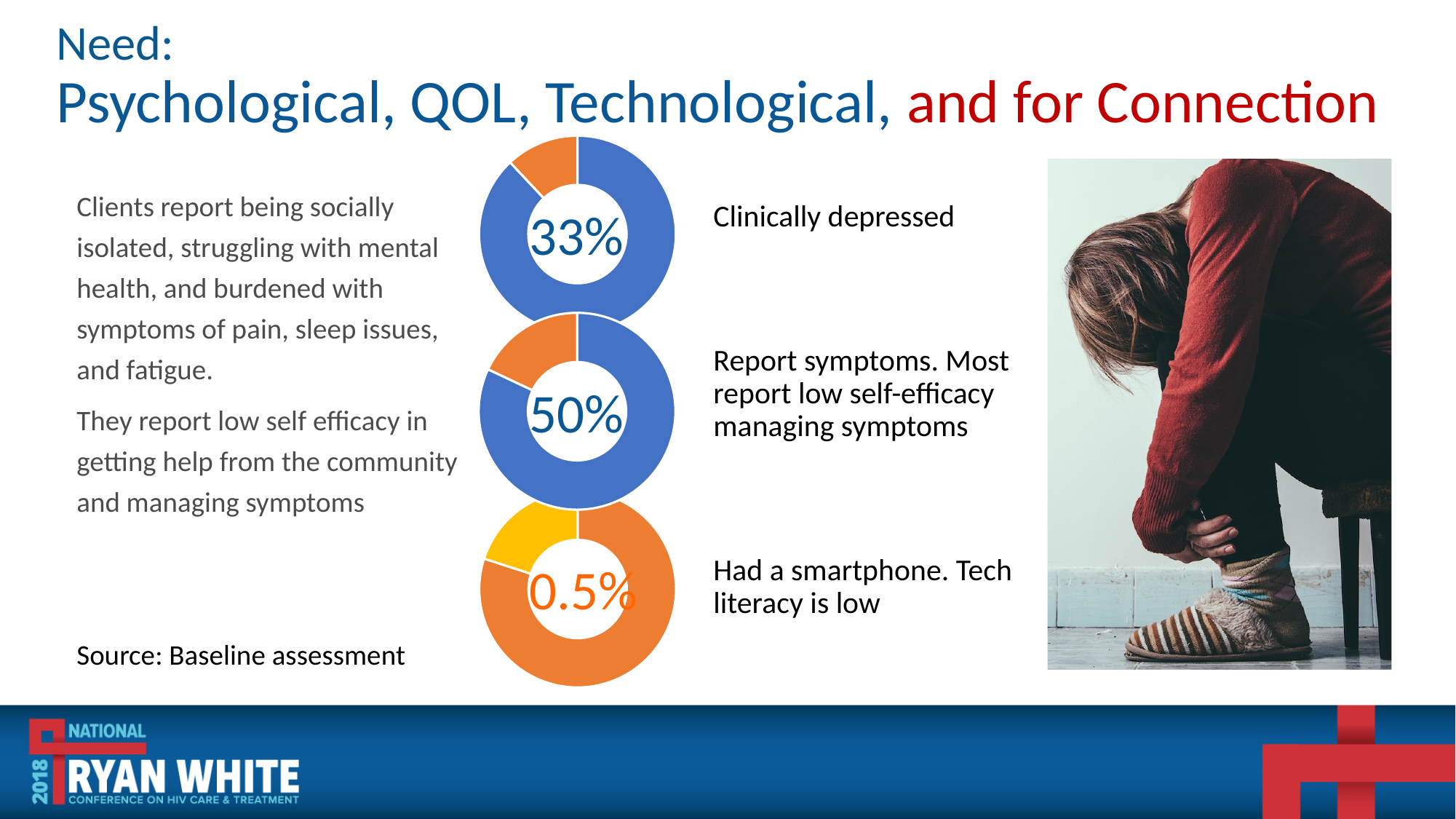
Which of the three donut charts shows the highest printed percentage? The middle chart (Report symptoms), 50% What source is cited for the data in the donut charts? Baseline assessment What percentage is shown in the centre of the top donut chart, labelled "Clinically depressed"? 33% What percentage is shown in the centre of the bottom donut chart, labelled "Had a smartphone"? 0.5% How many donut charts are shown on the slide? 3 What kind of chart is used to display the 33%, 50% and 0.5% figures? Donut (pie) chart Which is larger: the percentage printed on the top donut chart (Clinically depressed) or on the middle donut chart (Report symptoms)? The middle chart (Report symptoms), 50% What percentage is shown in the centre of the middle donut chart, labelled "Report symptoms"? 50% Which of the three donut charts shows the lowest printed percentage? The bottom chart (Had a smartphone), 0.5% What is the main colour of the ring in the bottom donut chart (Had a smartphone)? Orange What is the difference between the percentage printed on the middle donut chart and the percentage printed on the top donut chart? 17%